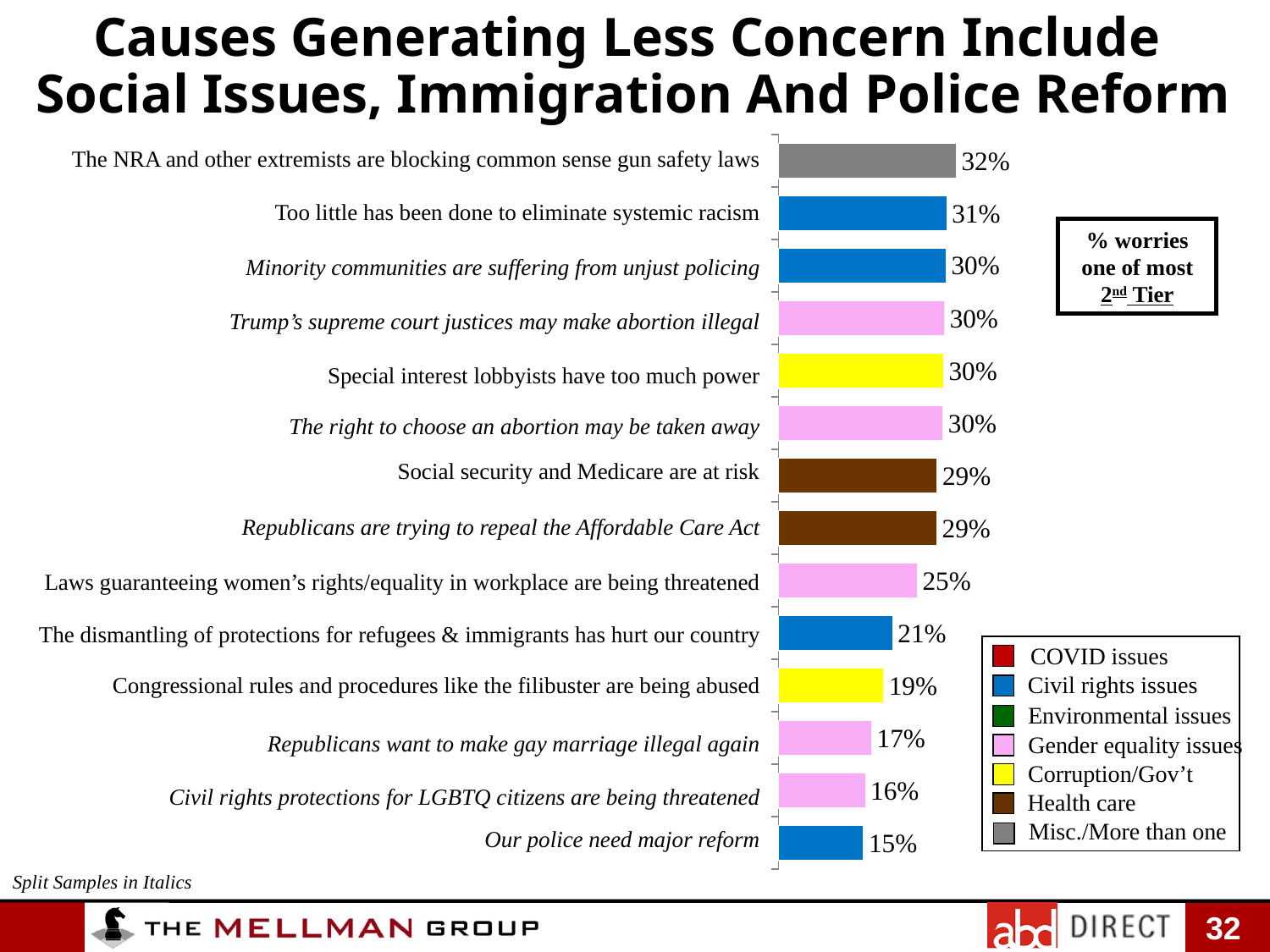
What kind of chart is shown on the slide? Bar chart Which category has the lowest value on the chart? Our police need major reform According to the legend, which issue category does the yellow colour represent? Corruption/Gov't How many entries does the legend list? 7 What is the difference between the value for 'Too little has been done to eliminate systemic racism' and the value for 'Our police need major reform'? 16% How many categories are plotted on the chart? 14 Which category has the highest value on the chart? The NRA and other extremists are blocking common sense gun safety laws What is the value for 'The dismantling of protections for refugees & immigrants has hurt our country'? 21% What is the value for 'Our police need major reform'? 15% What percentage worries about the NRA and other extremists blocking common sense gun safety laws? 32% Which is larger: the value for 'Congressional rules and procedures like the filibuster are being abused' or the value for 'Republicans want to make gay marriage illegal again'? Congressional rules and procedures like the filibuster are being abused What is the value for 'Laws guaranteeing women's rights/equality in workplace are being threatened'? 25%